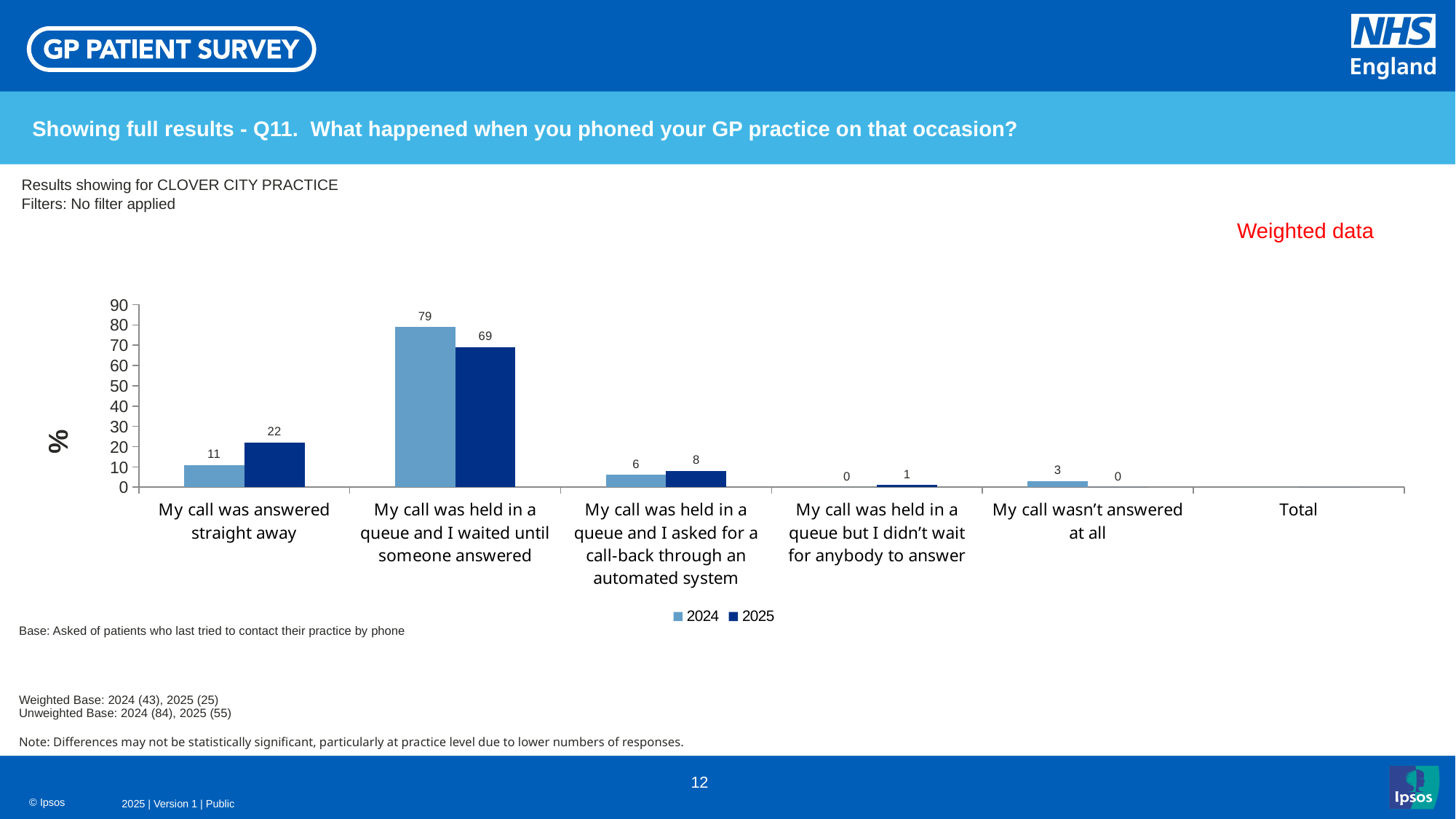
Which category has the highest 2025 value? My call was held in a queue and I waited until someone answered What kind of chart is shown on the slide? Bar chart What is the difference between the 2024 and 2025 values for 'My call was held in a queue and I waited until someone answered'? 10 What is the 2025 value for 'My call was answered straight away'? 22 What is the 2024 value for 'My call wasn't answered at all'? 3 Which category has the lowest 2024 value? My call was held in a queue but I didn't wait for anybody to answer What is the 2024 value for 'My call was held in a queue and I waited until someone answered'? 79 For 'My call was answered straight away', which year has the larger value, 2024 or 2025? 2025 What label is shown on the vertical axis of the chart? % Is the 2024 value for 'My call was held in a queue and I waited until someone answered' greater or less than 70? greater How many series does the legend list? 2 What is the 2025 value for 'My call was held in a queue and I asked for a call-back through an automated system'? 8